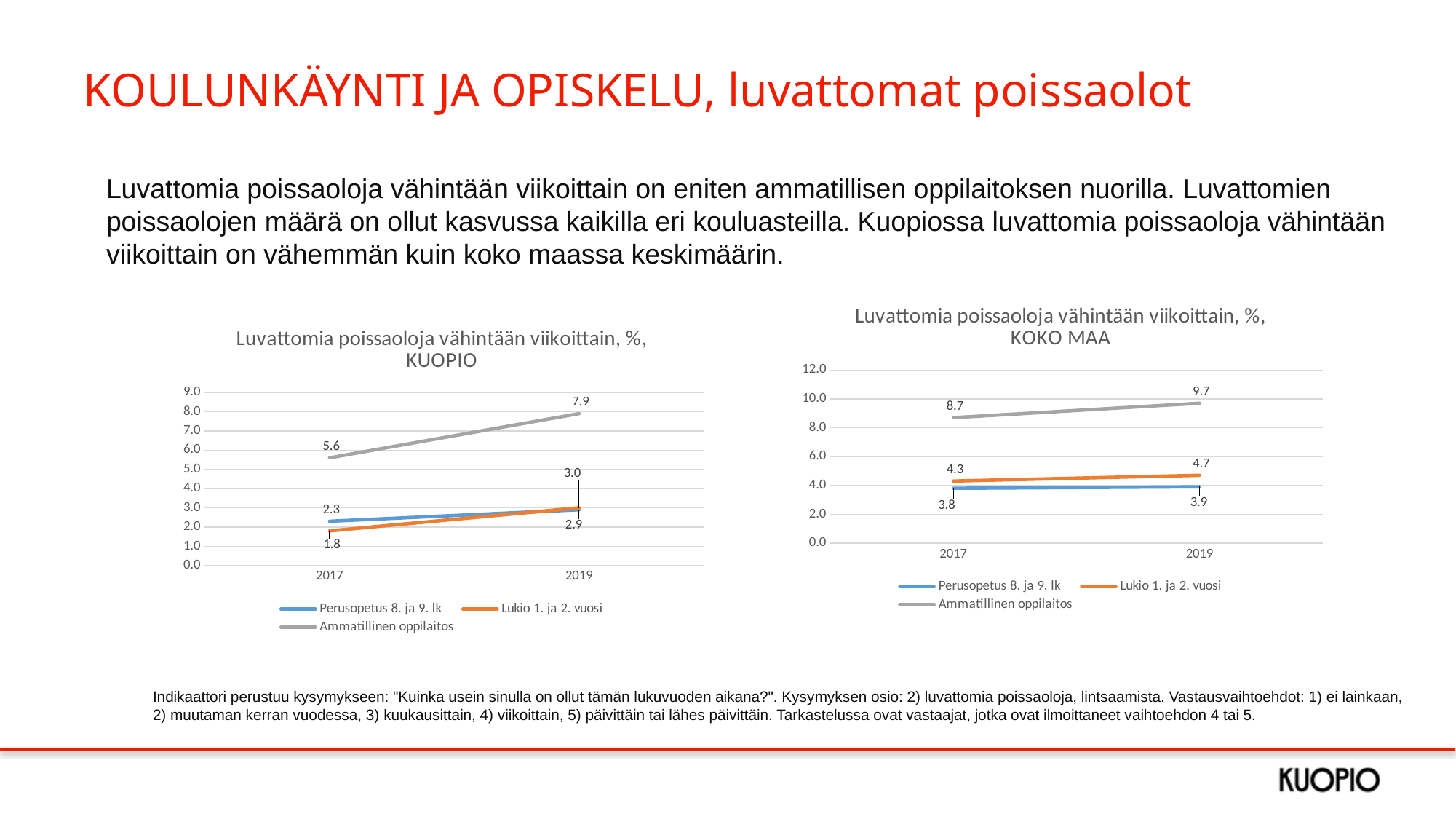
In the KUOPIO chart, which series has the highest value in 2019? Ammatillinen oppilaitos In the KOKO MAA chart, which is larger in 2017: Lukio 1. ja 2. vuosi or Perusopetus 8. ja 9. lk? Lukio 1. ja 2. vuosi In the KOKO MAA chart, what is the difference between Ammatillinen oppilaitos and Lukio 1. ja 2. vuosi in 2019? 5.0 What type of chart is the KUOPIO chart? line chart In the KOKO MAA chart, what is the value for Perusopetus 8. ja 9. lk in 2019? 3.9 How many series does the legend of the KOKO MAA chart list? 3 In the KUOPIO chart, what is the value for Ammatillinen oppilaitos in 2019? 7.9 In the KUOPIO chart, does the value for Ammatillinen oppilaitos rise or fall from 2017 to 2019? rise In the KUOPIO chart, by how much did the value for Ammatillinen oppilaitos increase from 2017 to 2019? 2.3 In the KOKO MAA chart, what is the value for Ammatillinen oppilaitos in 2017? 8.7 In the KOKO MAA chart, which series has the lowest value in 2017? Perusopetus 8. ja 9. lk In the KUOPIO chart, what is the value for Lukio 1. ja 2. vuosi in 2017? 1.8